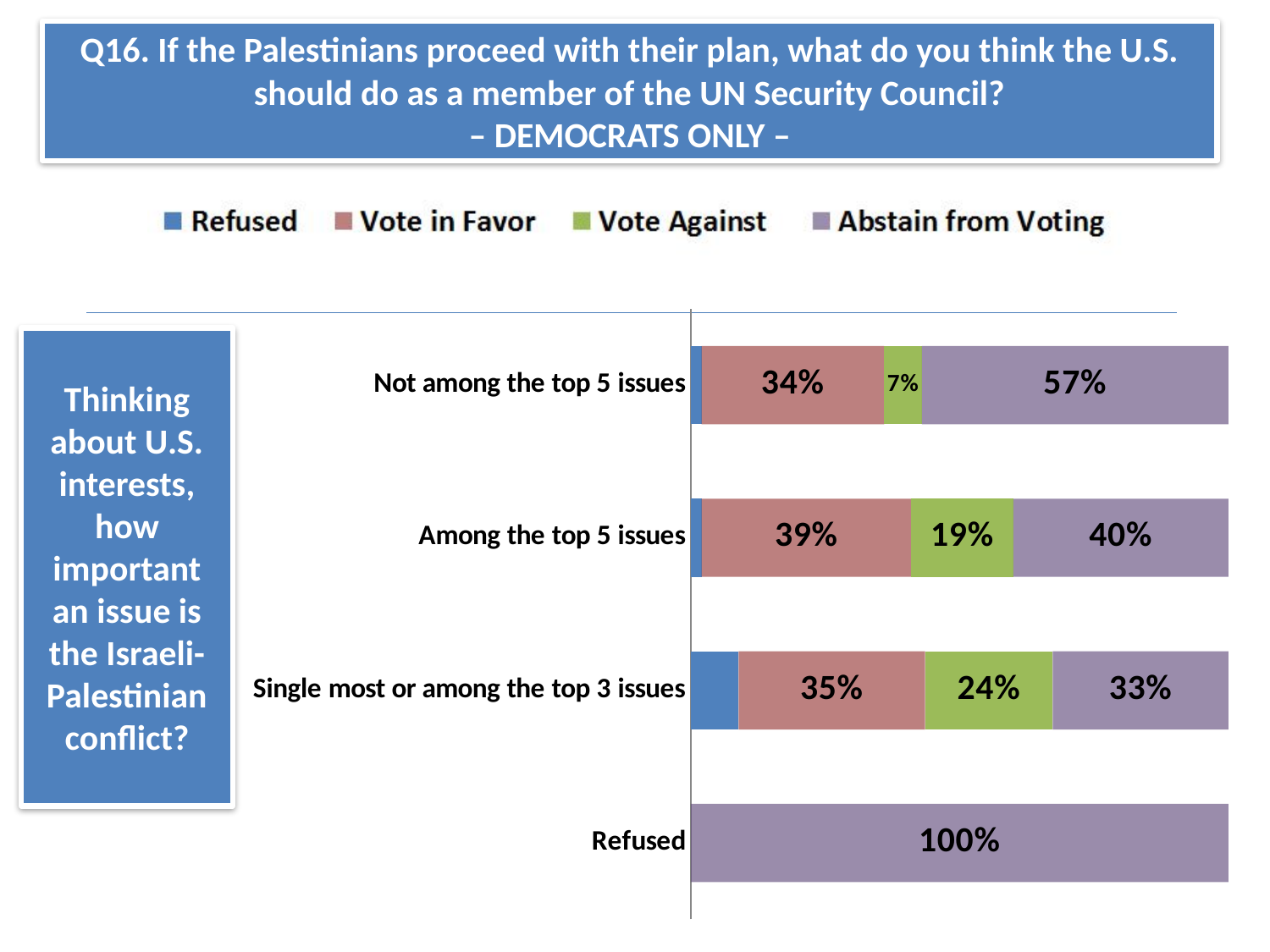
How many series does the legend list? 4 What is the Abstain from Voting value for the 'Not among the top 5 issues' category? 57% What kind of chart is shown on the slide? Stacked horizontal bar chart How many categories are shown on the chart? 4 Which category has the highest Abstain from Voting value? Refused In the 'Not among the top 5 issues' category, how many percentage points higher is Abstain from Voting than Vote in Favor? 23 percentage points What is the difference in Vote Against between 'Single most or among the top 3 issues' and 'Not among the top 5 issues'? 17 percentage points Which category has a larger Vote Against value: 'Among the top 5 issues' or 'Single most or among the top 3 issues'? Single most or among the top 3 issues What is the Abstain from Voting value for the 'Refused' category? 100% What percentage of Democrats who say the conflict is among the top 5 issues think the U.S. should vote in favor? 39% Which category has the highest Vote Against value? Single most or among the top 3 issues What is the Vote Against value for the 'Single most or among the top 3 issues' category? 24%